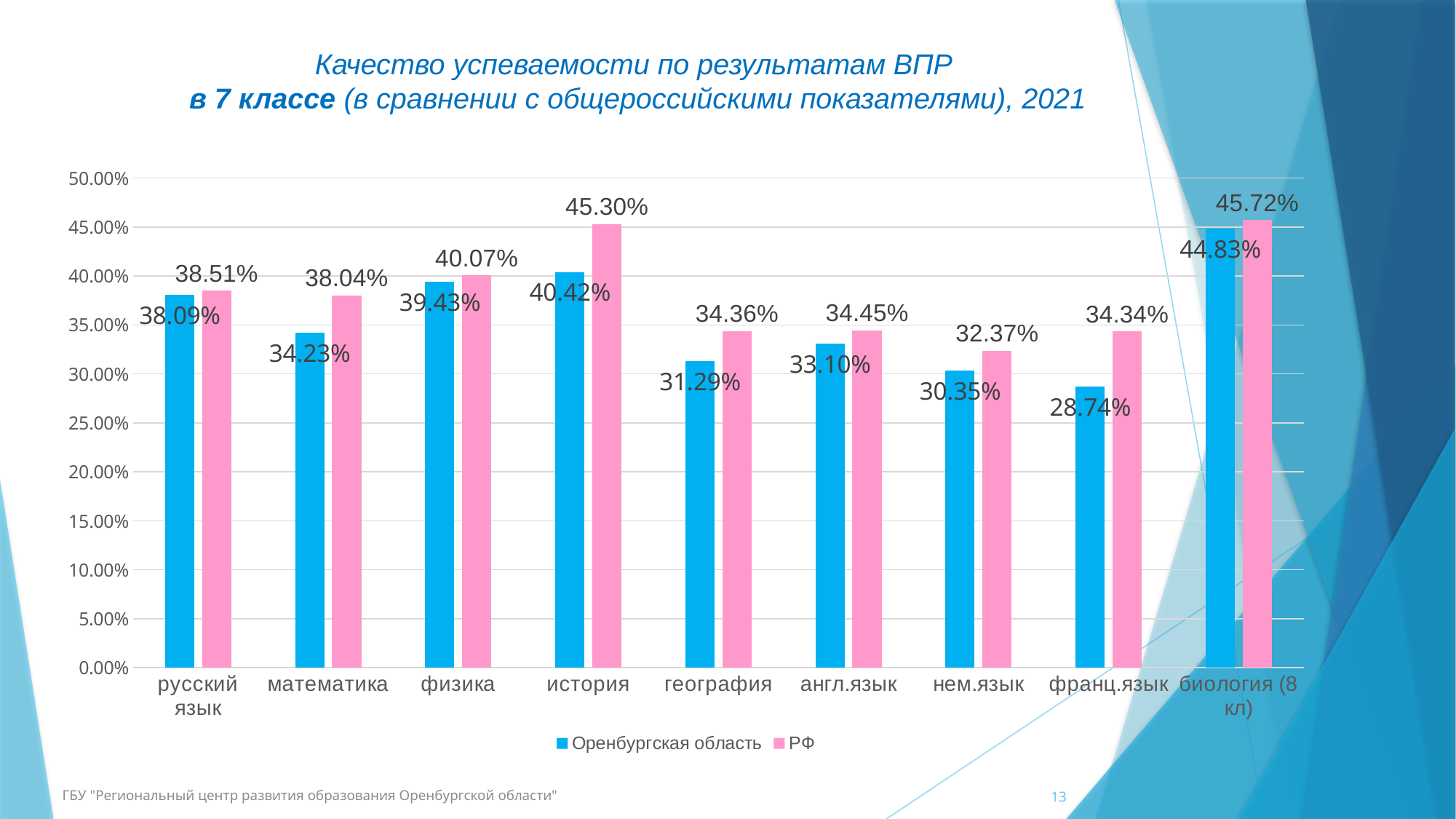
What is the value for РФ in франц.язык? 34.34% What kind of chart is shown on the slide? bar chart What is the value for Оренбургская область in история? 40.42% Which category has the highest value for РФ? биология (8 кл) How many categories are shown on the x axis? 9 How many series does the legend list? 2 What is the value for Оренбургская область in биология (8 кл)? 44.83% Is the value for Оренбургская область in география greater or less than 35.00%? less Which is larger for математика: the value for Оренбургская область or for РФ? РФ What is the difference between the РФ and Оренбургская область values for история? 4.88% Which category has the lowest value for Оренбургская область? франц.язык Which series is shown in pink in the legend? РФ